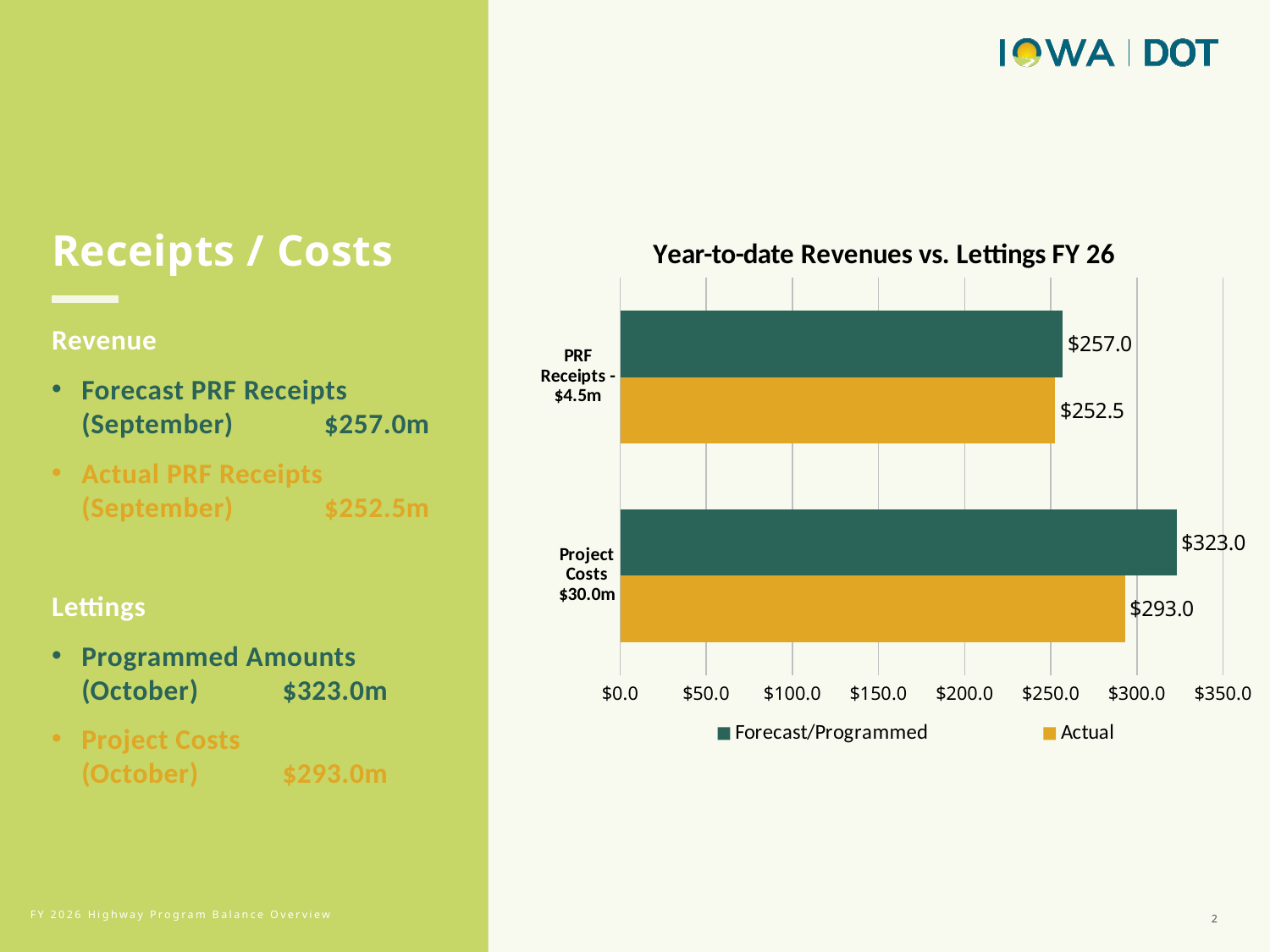
Which is larger for Project Costs, the Forecast/Programmed value or the Actual value? Forecast/Programmed Which category has the lowest Actual value? PRF Receipts What is the Forecast/Programmed value for PRF Receipts? $257.0 Which category has the highest Forecast/Programmed value? Project Costs What is the difference between the Forecast/Programmed and Actual values for Project Costs? $30.0 How many series does the legend list? 2 What is the title of the chart? Year-to-date Revenues vs. Lettings FY 26 What is the Actual value for PRF Receipts? $252.5 What kind of chart is shown on the slide? Bar chart What is the difference between the Forecast/Programmed and Actual values for PRF Receipts? $4.5 What is the Forecast/Programmed value for Project Costs? $323.0 What is the Actual value for Project Costs? $293.0